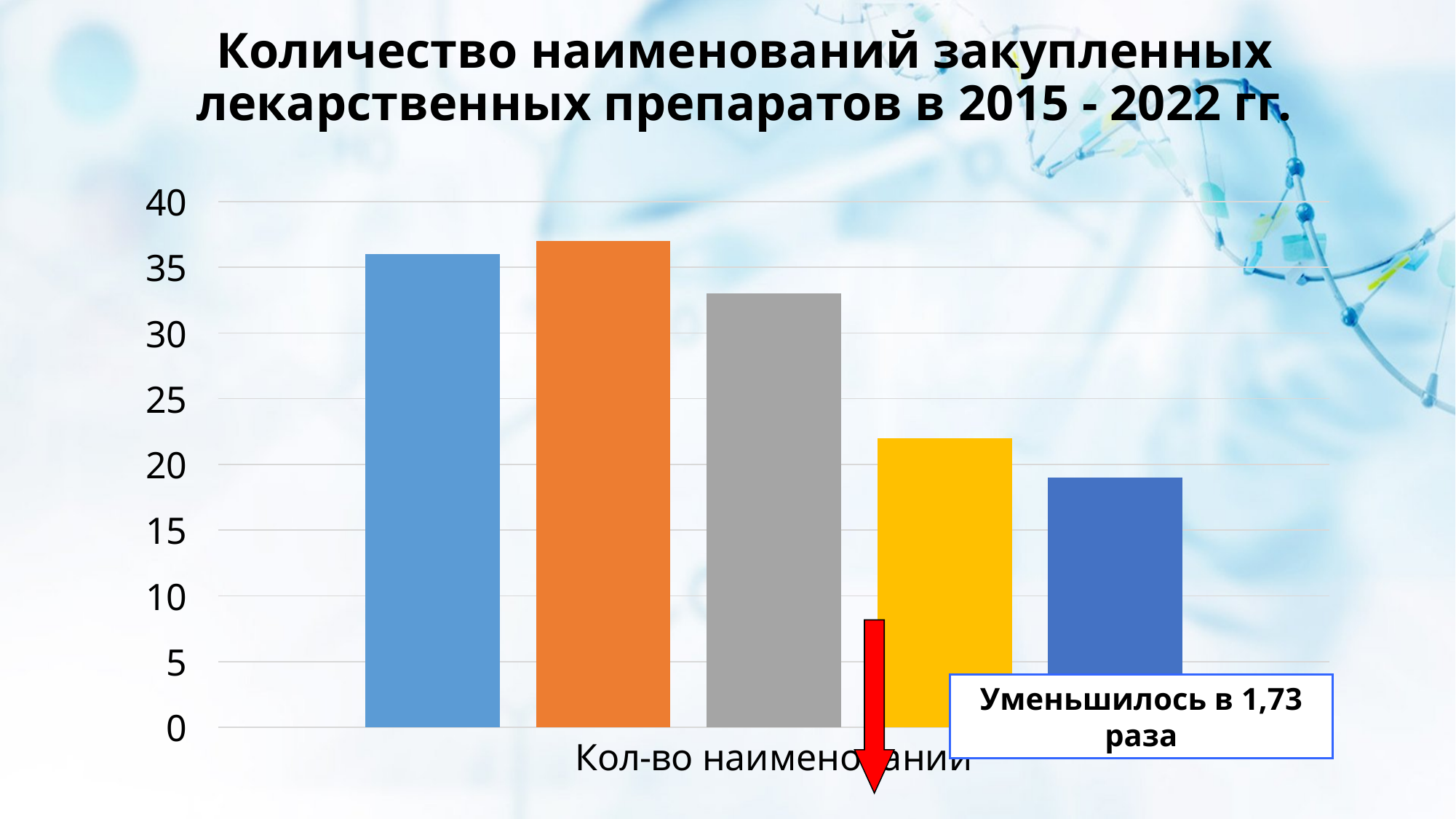
How many bars are plotted in the chart? 5 Is the value of the leftmost (light blue) bar greater or less than 30? greater What does the text box at the bottom right of the chart say? Уменьшилось в 1,73 раза Which bar is the lowest in the chart? the rightmost (dark blue) bar Is the value of the yellow bar greater or less than 25? less Is the value of the gray bar greater or less than 30? greater Do the bar values generally rise or fall from left to right across the chart? fall What is the title of the chart? Количество наименований закупленных лекарственных препаратов в 2015 - 2022 гг. Which is larger, the gray bar or the yellow bar? the gray bar What kind of chart is shown on the slide? bar chart